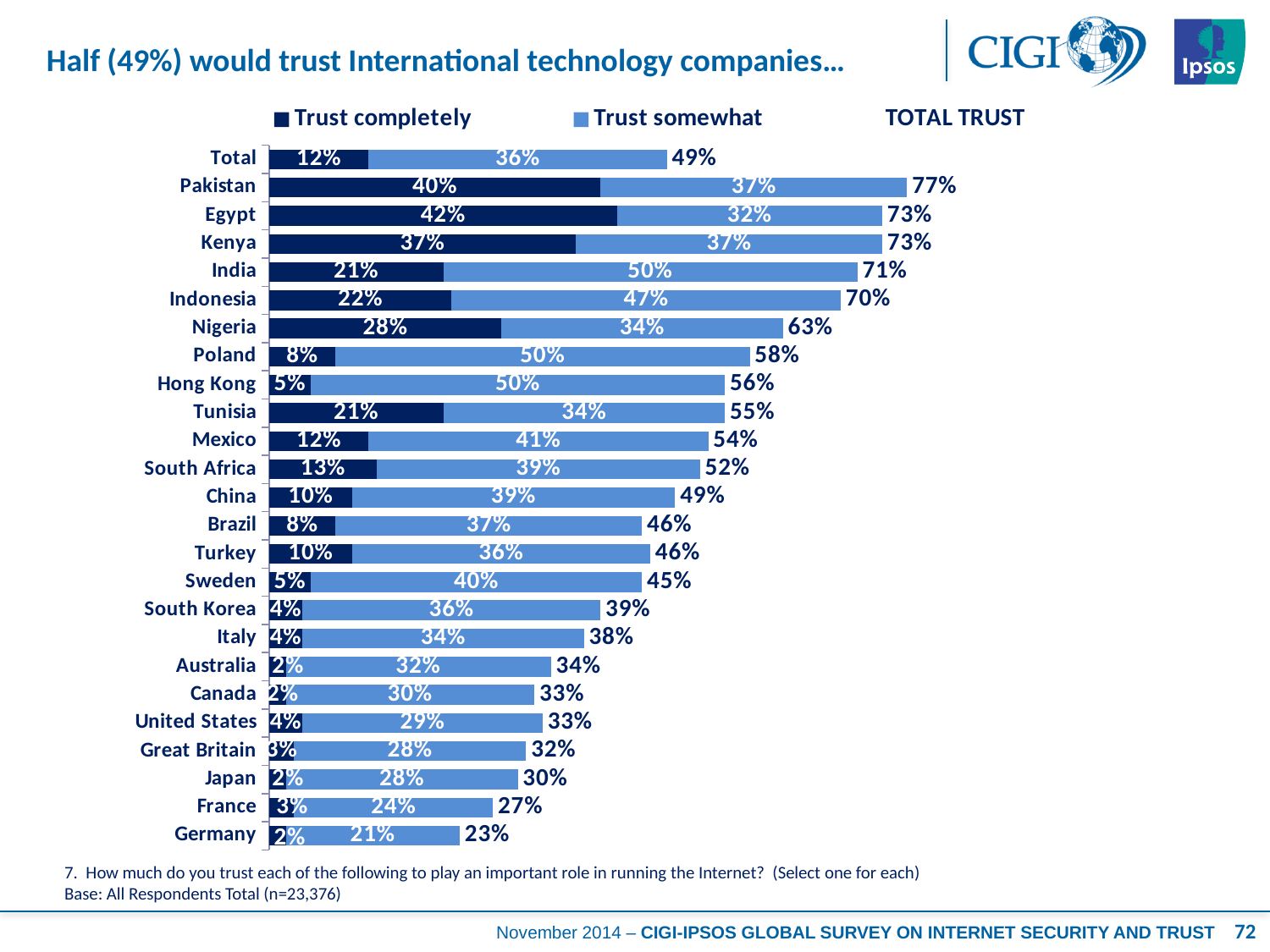
What is the difference between the TOTAL TRUST values for Pakistan and Germany? 54% Which country has the highest TOTAL TRUST value? Pakistan What is the total of the stacked bar for Poland? 58% Do the TOTAL TRUST values rise or fall going down the list of countries from Pakistan to Germany? Fall What is the 'Trust somewhat' value for India? 50% What is the TOTAL TRUST value for Nigeria? 63% How many series does the legend list? 2 Which country has the lowest TOTAL TRUST value? Germany What is the 'Trust completely' value for Egypt? 42% What is the 'Trust completely' value for the Total row? 12% Which has a larger 'Trust completely' value, Kenya or Indonesia? Kenya What kind of chart is shown on the slide? Stacked bar chart